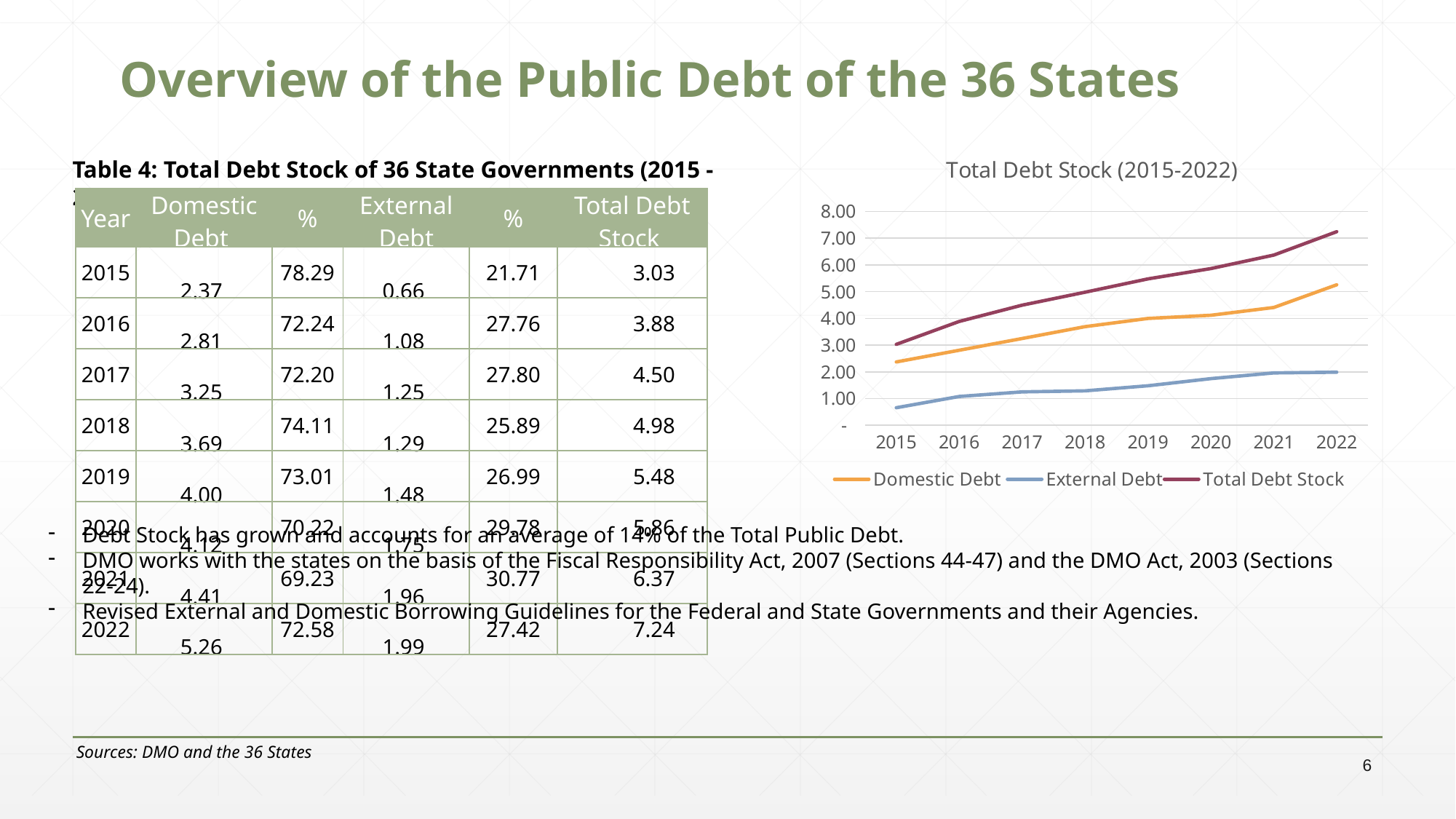
In which year is External Debt lowest? 2015 What is the title of the chart on the slide? Total Debt Stock (2015-2022) In which year is the Total Debt Stock highest? 2022 Is the Domestic Debt value for 2022 greater or less than 5.00? greater In 2019, which is larger: Domestic Debt or External Debt? Domestic Debt What kind of chart is shown on the slide? line chart Is the Total Debt Stock value for 2022 greater or less than 7.00? greater How many series does the legend of the Total Debt Stock chart list? 3 Does the Total Debt Stock line rise or fall from 2015 to 2022? rise Is the Total Debt Stock value for 2015 greater or less than 4.00? less How many years are plotted along the x axis of the Total Debt Stock chart? 8